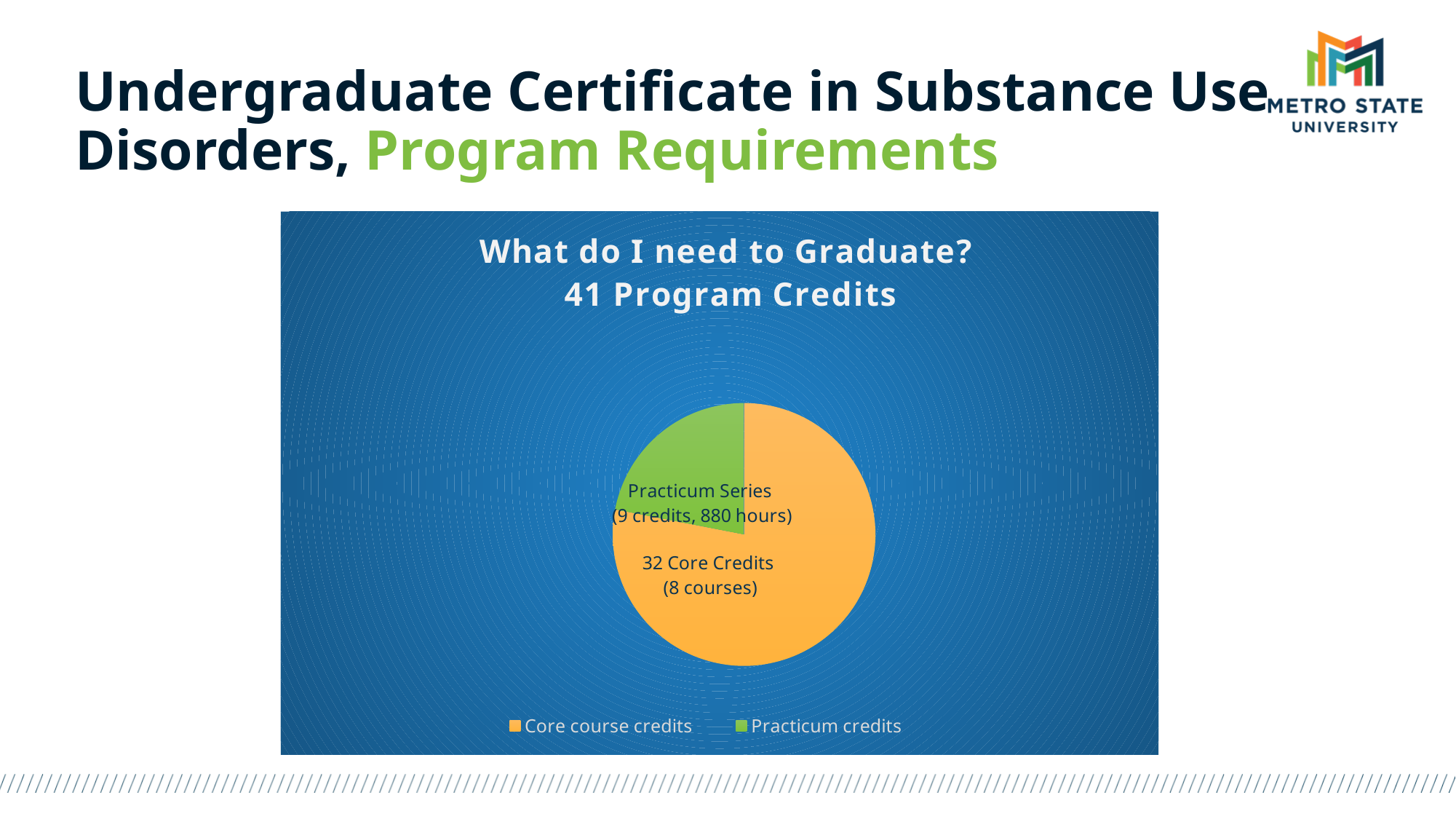
How many credits does the Core course credits slice represent? 32 How many more credits are Core course credits than Practicum credits? 23 How many hours are listed for the Practicum Series? 880 hours How many slices does the pie chart have? 2 How many entries does the legend list? 2 How many credits does the Practicum credits slice represent? 9 What is the total number of program credits stated in the chart title? 41 How many courses make up the 32 Core Credits? 8 courses Which slice of the pie is the smallest? Practicum credits Which slice of the pie is the largest? Core course credits What kind of chart is shown on the slide? pie chart Which is larger, Core course credits or Practicum credits? Core course credits